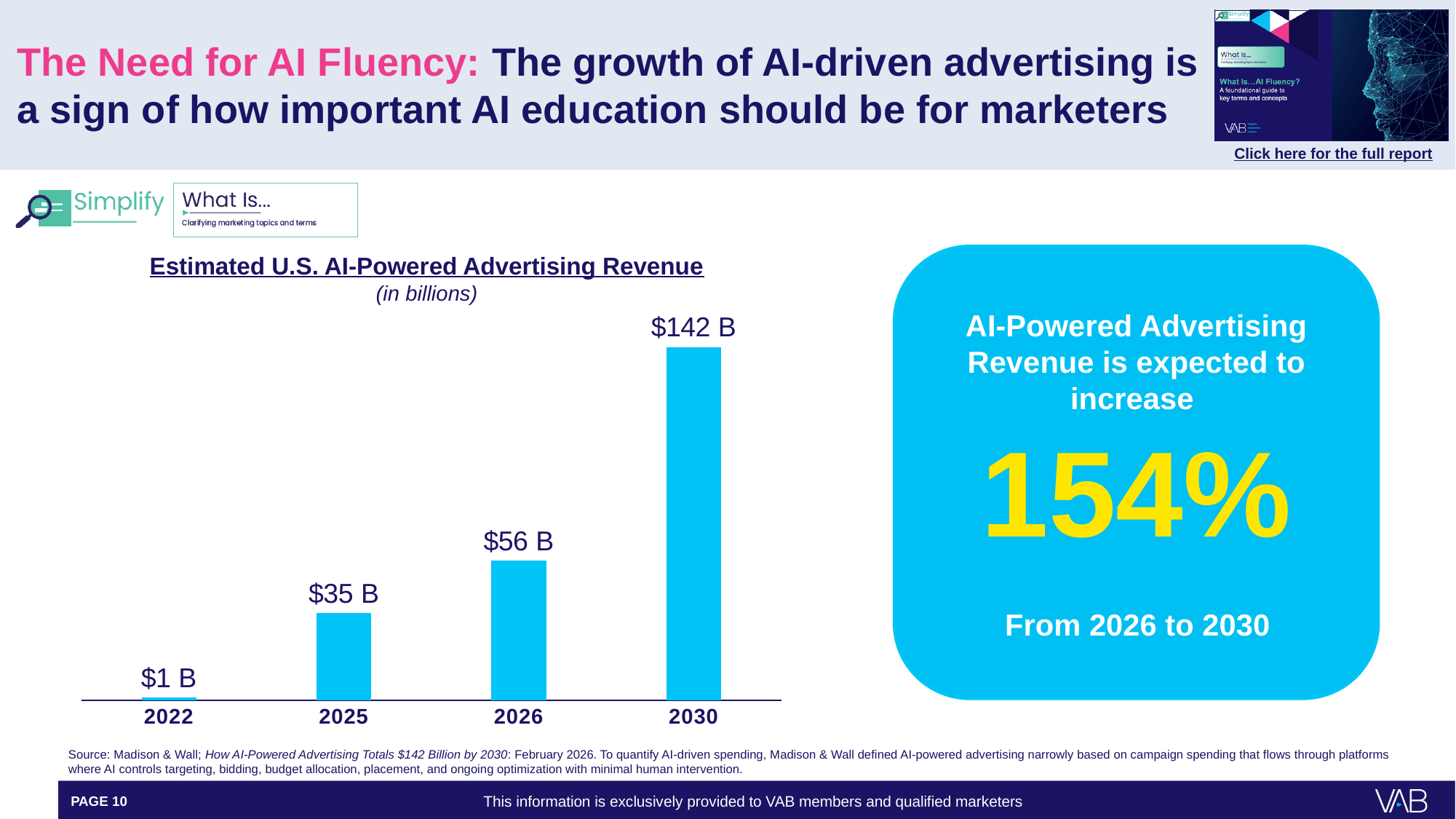
What is the difference between the estimated revenue for 2030 and 2026? $86 B How many years are shown on the chart? 4 What kind of chart is used to show the estimated AI-powered advertising revenue? Bar chart What is the difference between the estimated revenue for 2026 and 2025? $21 B Do the estimated revenue values rise or fall from 2022 to 2030? Rise Which year has the highest estimated AI-powered advertising revenue? 2030 Which year has the lowest estimated AI-powered advertising revenue? 2022 What is the estimated U.S. AI-powered advertising revenue for 2026? $56 B What is the estimated U.S. AI-powered advertising revenue for 2030? $142 B Which year has the larger estimated revenue, 2025 or 2026? 2026 What is the title of the chart? Estimated U.S. AI-Powered Advertising Revenue What is the estimated U.S. AI-powered advertising revenue for 2022? $1 B